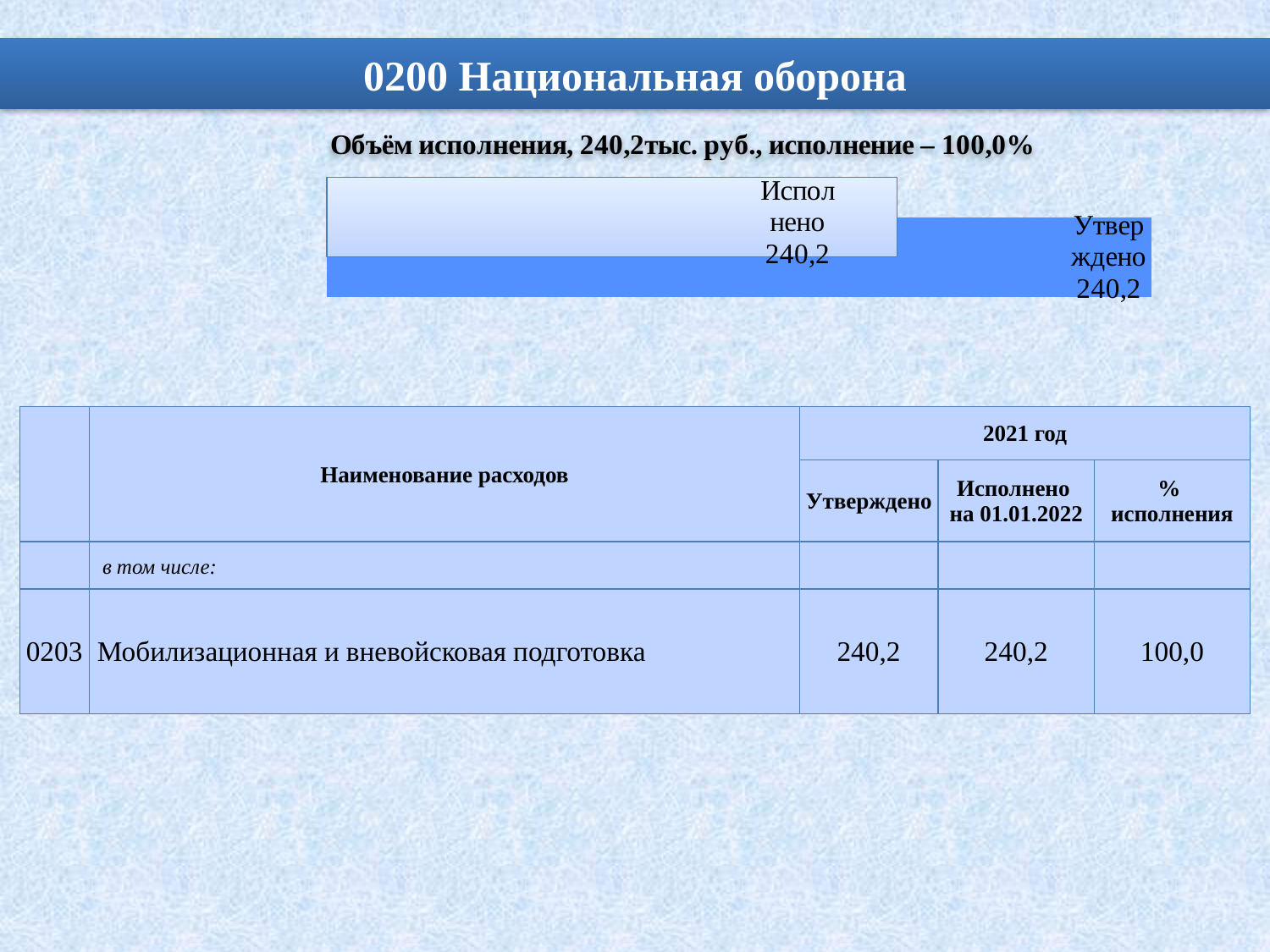
What type of chart is shown on the slide? bar chart Which bar in the chart is drawn in the darker blue colour? Утверждено Are the bars in the chart oriented horizontally or vertically? horizontally What is the value of the Исполнено bar in the chart? 240,2 What is the difference between the Утверждено and Исполнено values in the chart? 0,0 What is the value of the Утверждено bar in the chart? 240,2 How many bars are plotted in the chart? 2